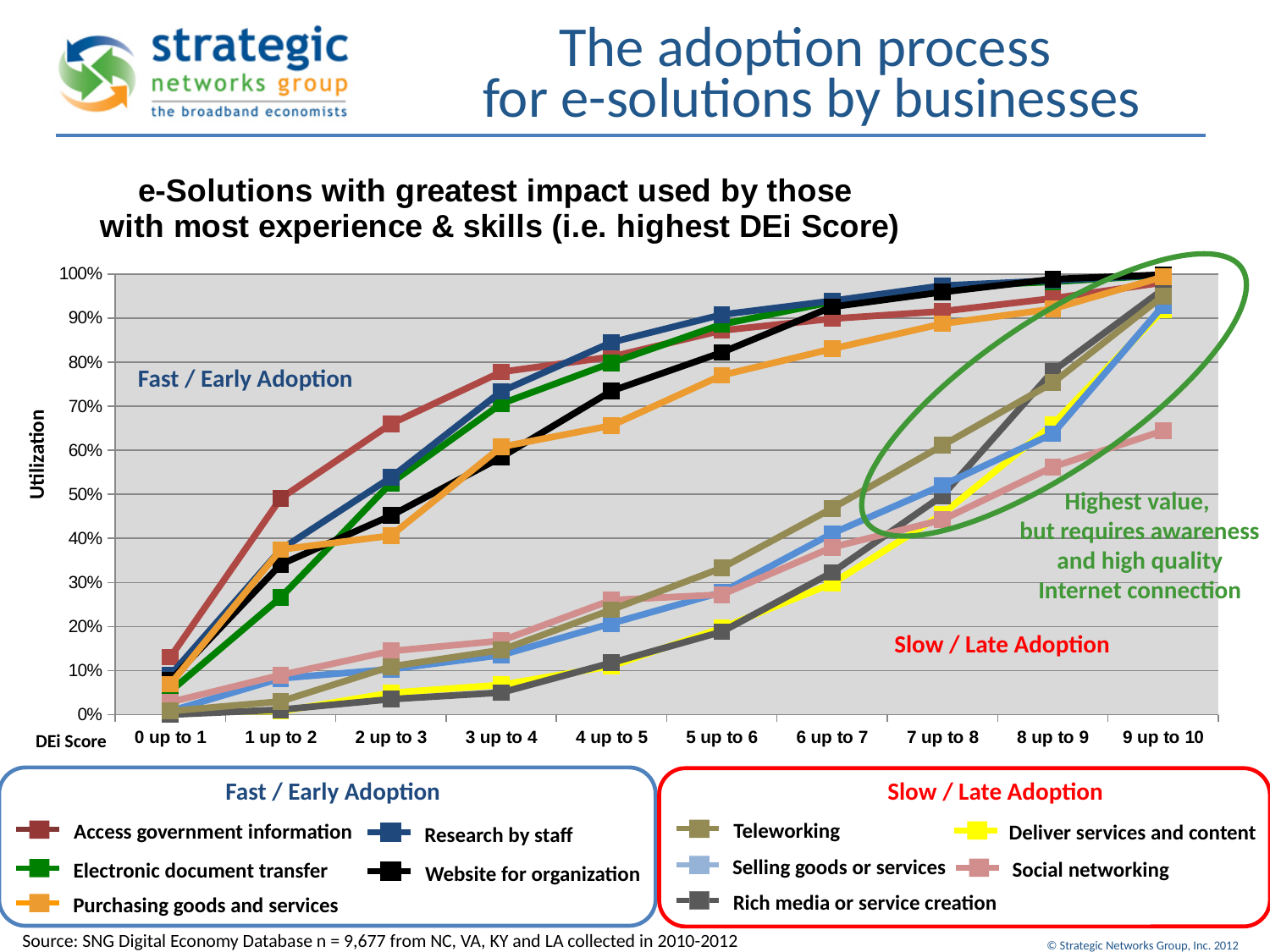
Is the utilization for Rich media or service creation at '5 up to 6' greater or less than 30%? less Is the utilization for Teleworking at '7 up to 8' greater or less than 50%? greater Is the utilization for Website for organization at '4 up to 5' greater or less than 60%? greater At '9 up to 10', which series has the lowest utilization? Social networking What kind of chart is shown on the slide? line chart Does the utilization for Access government information rise or fall as the DEi Score increases? rise How many series does the legend list in total? 10 How many DEi Score categories are shown along the x axis? 10 What are the names of the two groups into which the legend divides the series? Fast / Early Adoption and Slow / Late Adoption At '0 up to 1', which has higher utilization: Access government information or Deliver services and content? Access government information